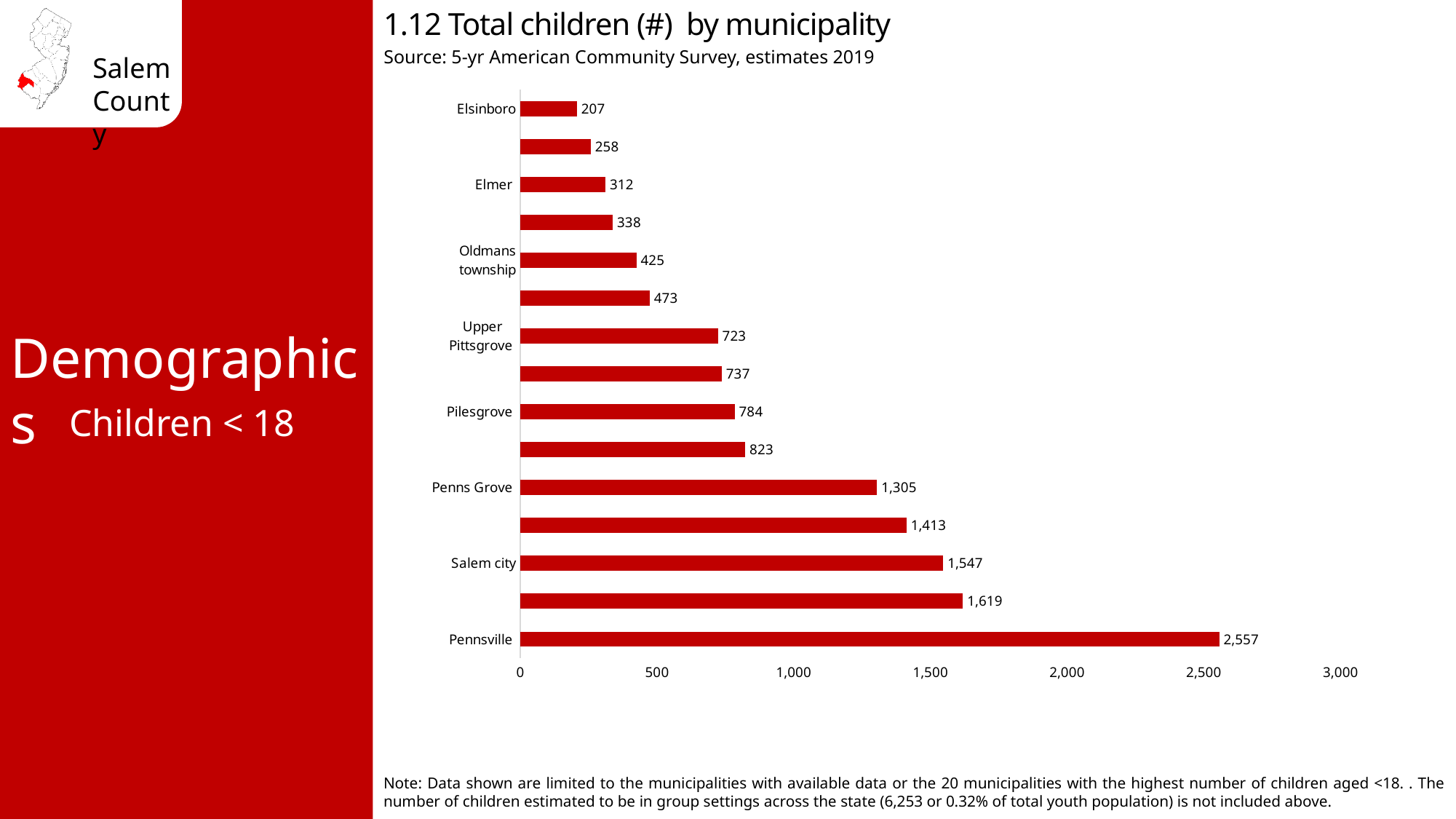
Which municipality has the lowest number of children? Elsinboro What is the total number of children for Pennsville? 2,557 What is the difference between the number of children in Pennsville and Salem city? 1,010 Which municipality has the highest number of children? Pennsville Is the value for Penns Grove greater or less than 1,000? greater How many bars are plotted in the chart? 15 What type of chart is shown on the slide? Bar chart What is the difference between the number of children in Pilesgrove and Upper Pittsgrove? 61 Which has more children, Elmer or Elsinboro? Elmer What is the total number of children for Salem city? 1,547 What is the total number of children for Oldmans township? 425 What is the total number of children for Penns Grove? 1,305